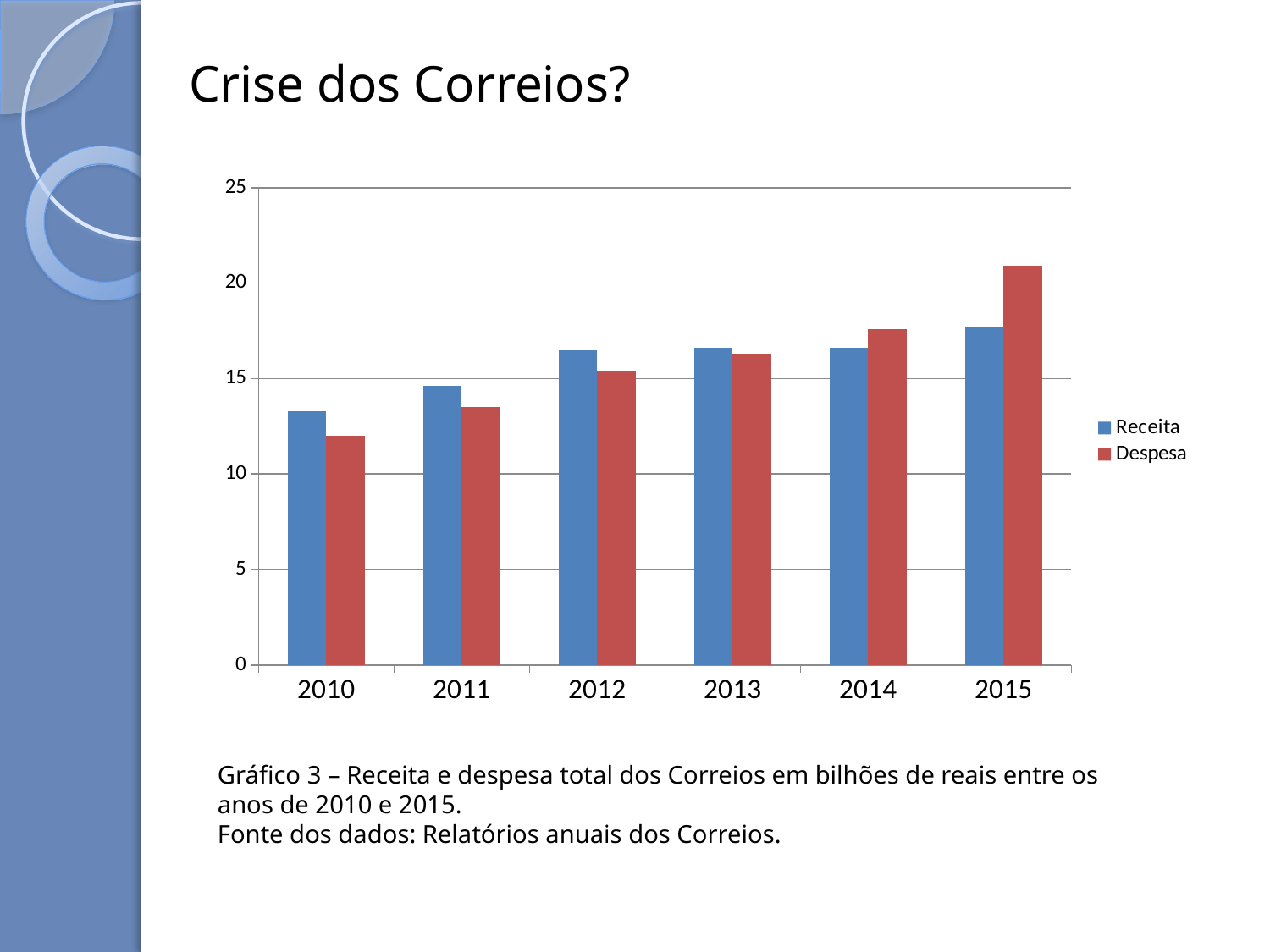
Is the value for Receita in 2010 greater or less than 15? less In which year is Despesa highest? 2015 Which colour represents Despesa in the legend? red In which year is Despesa lowest? 2010 In 2010, which is larger, Receita or Despesa? Receita What kind of chart is shown on the slide? bar chart How many years are shown on the x axis? 6 How many series does the legend list? 2 Is the value for Despesa in 2015 greater or less than 20? greater In which year is Receita lowest? 2010 Does Despesa rise or fall from 2010 to 2015? rise In 2015, which is larger, Receita or Despesa? Despesa